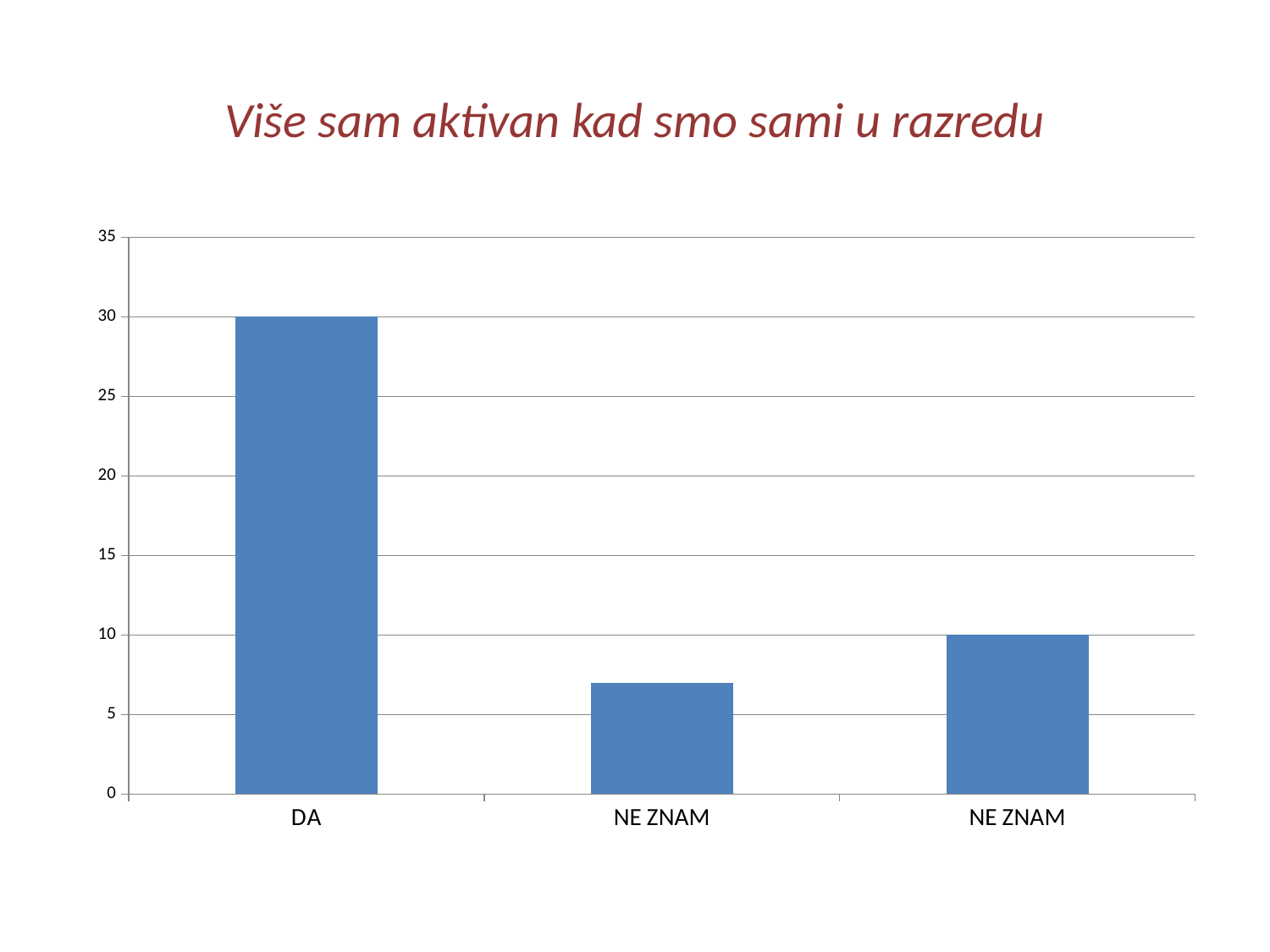
What is the value of the DA bar? 30 Which category has the highest value? DA What is the highest value shown on the vertical axis? 35 What is the title of the slide? Više sam aktivan kad smo sami u razredu Is the value of the middle NE ZNAM bar greater or less than 5? greater What is the difference between the DA bar and the rightmost NE ZNAM bar? 20 How many bars are shown in the chart? 3 What kind of chart is shown on the slide? bar chart What is the value of the rightmost bar (the second NE ZNAM bar)? 10 Is the value of the middle NE ZNAM bar greater or less than 10? less Which is larger, the DA bar or the middle NE ZNAM bar? DA Which bar is the shortest? the middle NE ZNAM bar